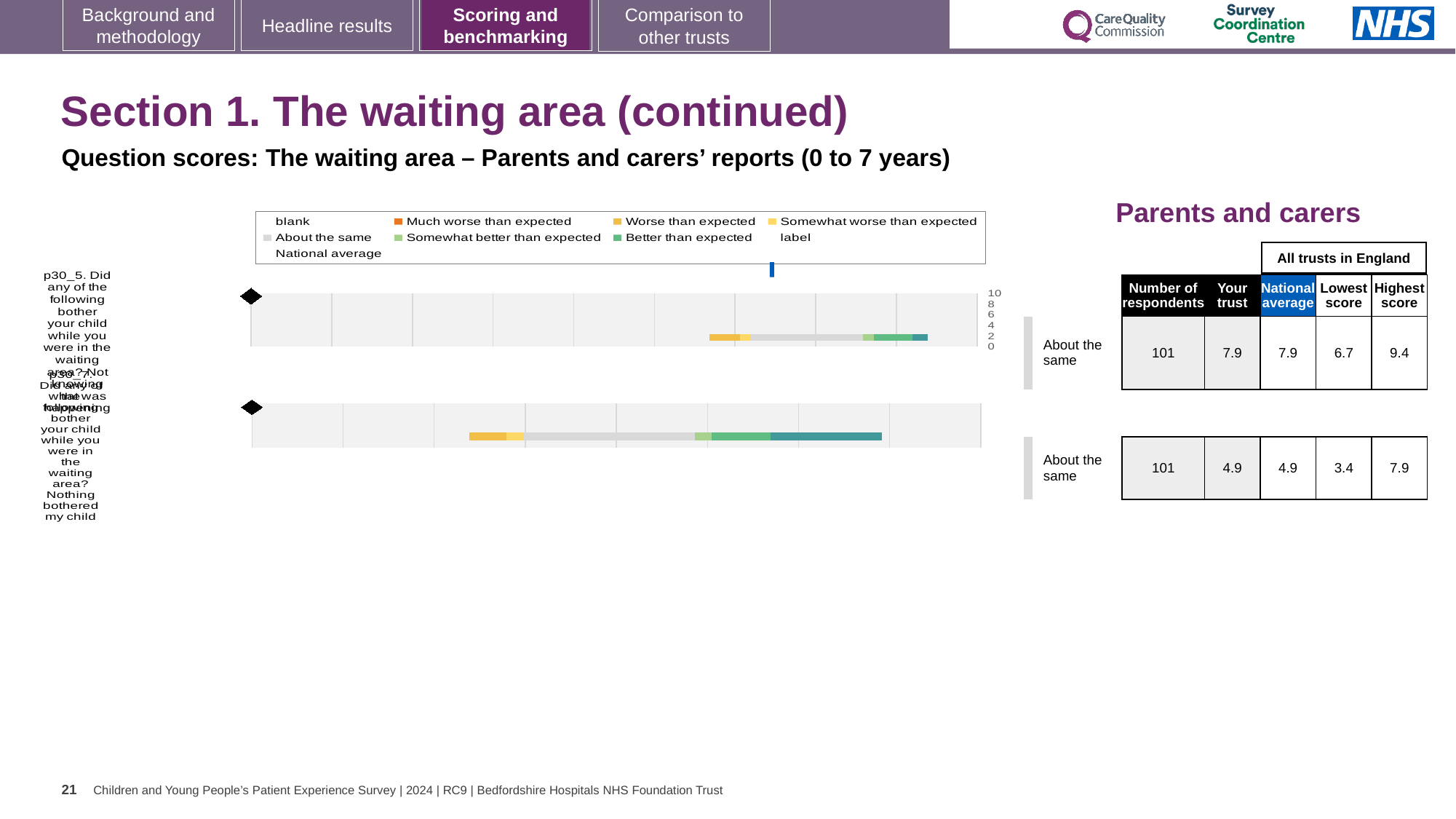
What colour does the legend use for 'Much worse than expected'? orange What colour does the legend use for 'About the same'? grey What is the difference between the highest score and the lowest score for question p30_7? 4.5 What is the number of respondents for question p30_5? 101 What is the highest score across all trusts in England for question p30_5? 9.4 What is the 'Your trust' score for question p30_7 (Nothing bothered my child)? 4.9 What is the lowest score across all trusts in England for question p30_7? 3.4 How many entries does the chart legend list? 9 Which question has the higher 'Your trust' score, p30_5 or p30_7? p30_5 How many questions (bars) are plotted in the chart? 2 What kind of chart is shown on the slide? bar chart What is the 'Your trust' score for question p30_5 (Not knowing what was happening)? 7.9